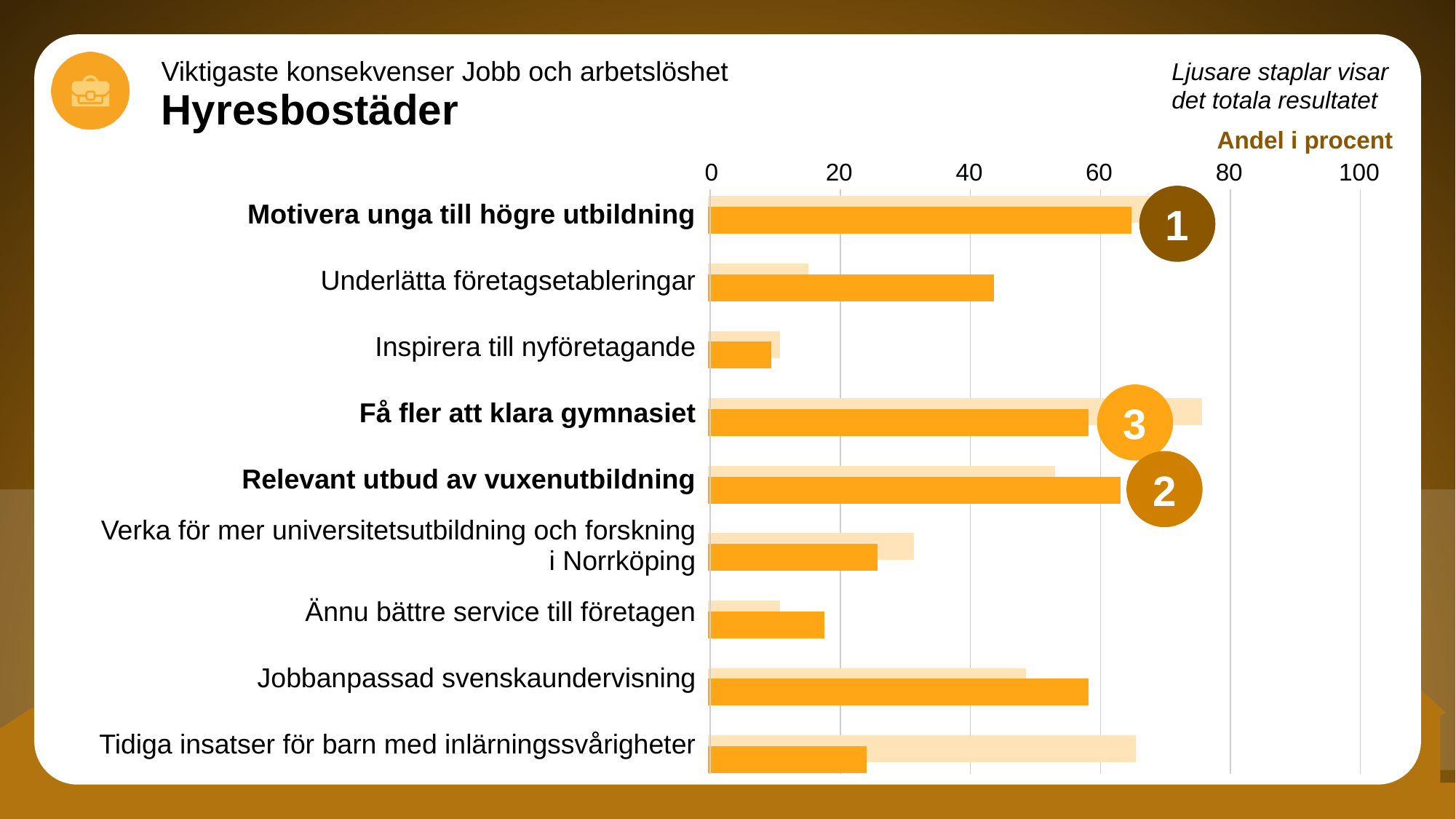
What kind of chart is shown on the slide? bar chart Which category is marked with the number 1 on the chart? Motivera unga till högre utbildning Is the lighter bar for Tidiga insatser för barn med inlärningssvårigheter greater or less than 60? greater Which category has the lowest value among the darker bars? Inspirera till nyföretagande Which has the larger darker bar: Underlätta företagsetableringar or Verka för mer universitetsutbildning och forskning i Norrköping? Underlätta företagsetableringar Is the darker bar for Ännu bättre service till företagen greater or less than 20? less Is the darker bar for Motivera unga till högre utbildning greater or less than 60? greater For Tidiga insatser för barn med inlärningssvårigheter, which bar is longer: the darker bar or the lighter bar? the lighter bar According to the note on the slide, what do the lighter bars show? det totala resultatet How many categories are plotted in the chart? 9